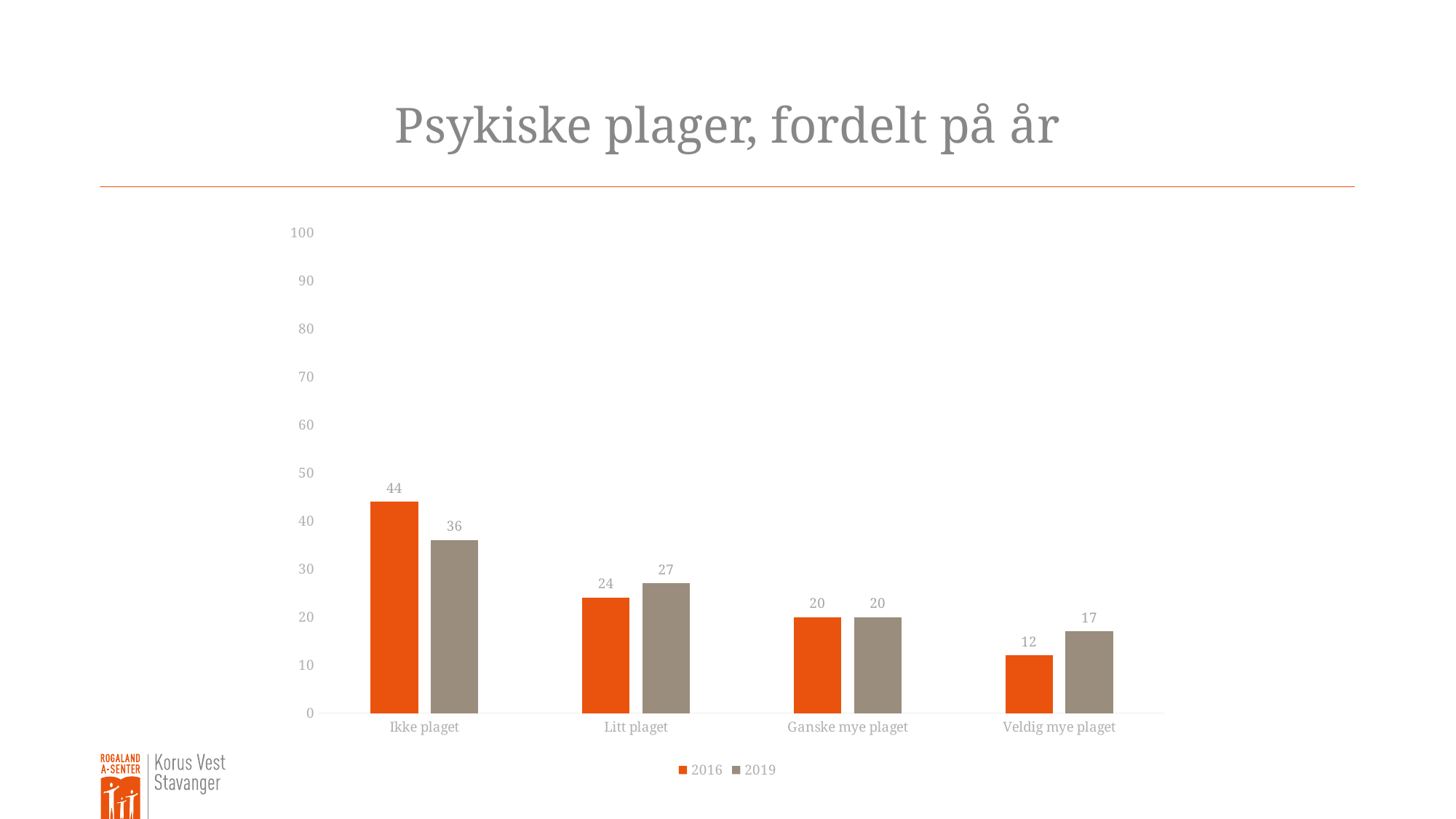
Is the 2019 value for 'Ikke plaget' greater or less than 30? greater What kind of chart is shown on the slide? Bar chart Which category has the lowest value for the 2016 series? Veldig mye plaget What is the title of the chart? Psykiske plager, fordelt på år How many series does the legend list? 2 What is the value for 'Ikke plaget' in 2016? 44 What is the difference between the 2016 and 2019 values for 'Ikke plaget'? 8 Which is larger for 'Veldig mye plaget': the 2016 value or the 2019 value? 2019 What is the value for 'Veldig mye plaget' in 2016? 12 What is the value for 'Litt plaget' in 2019? 27 Which category has the highest value for the 2019 series? Ikke plaget How many categories are shown on the x axis? 4